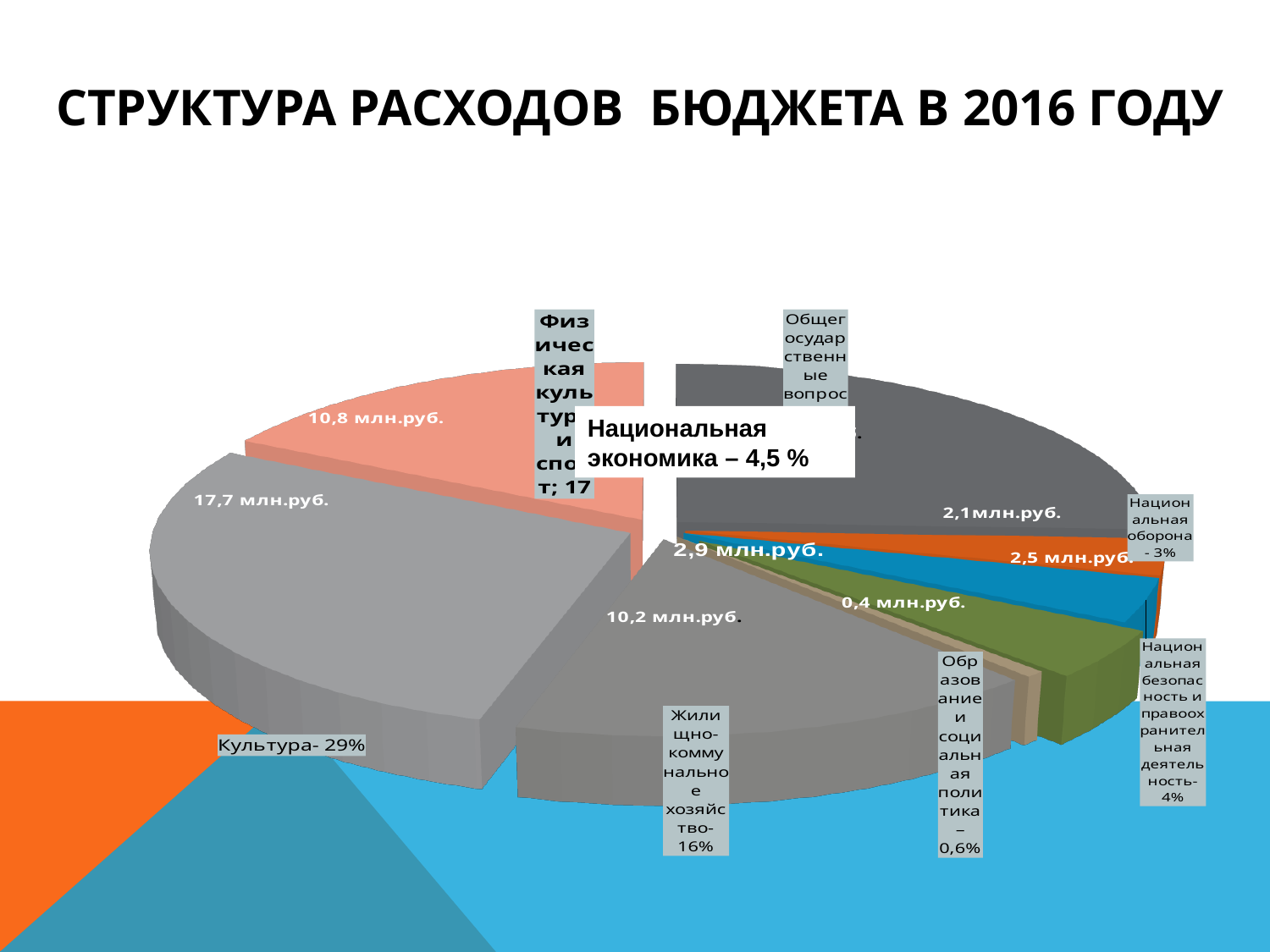
What share of the budget expenditure goes to Национальная безопасность и правоохранительная деятельность? 4% What kind of chart is shown on the slide? pie chart Which category has the largest share of the budget expenditure? Культура Which has a larger share: Культура or Жилищно-коммунальное хозяйство? Культура What share of the budget expenditure goes to Жилищно-коммунальное хозяйство? 16% Which category has the smallest share of the budget expenditure? Образование и социальная политика What is the title of the slide's chart? СТРУКТУРА РАСХОДОВ БЮДЖЕТА В 2016 ГОДУ What share of the budget expenditure goes to Культура? 29% By how many percentage points does the share of Культура exceed that of Жилищно-коммунальное хозяйство? 13